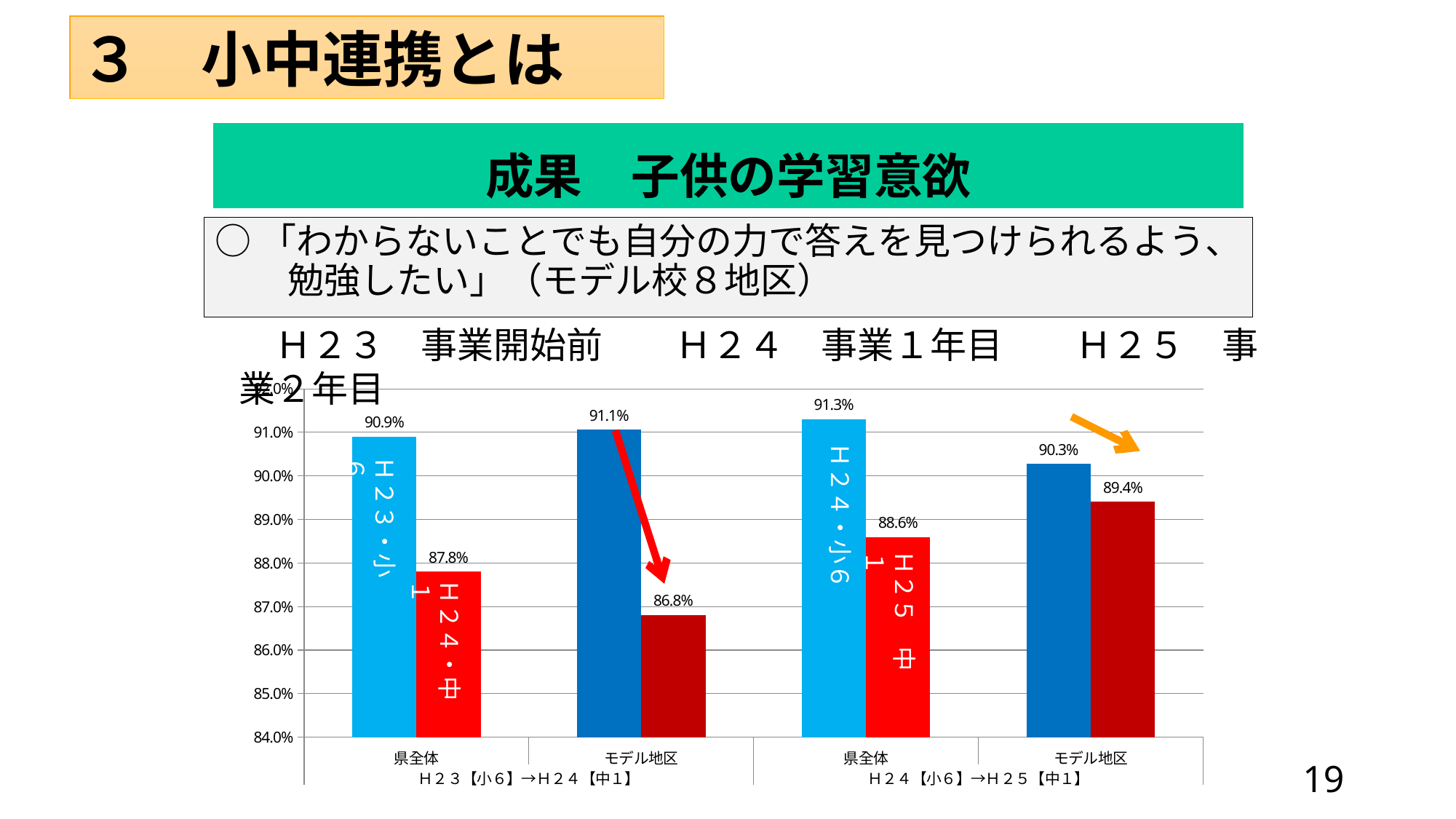
What is the difference between the 小6 and 中1 values for モデル地区 in the H24【小6】→H25【中1】 group? 0.9% In the H24【小6】→H25【中1】 group, what is the value of the H24・小6 bar for 県全体? 91.3% Is the value for 県全体 H24・中1 (87.8%) greater or less than 88.0%? less Which is larger: the 中1 value for 県全体 in the H23→H24 group (87.8%) or the 中1 value for 県全体 in the H24→H25 group (88.6%)? 88.6% (H24→H25 group) In the H23【小6】→H24【中1】 group, what is the value of the H23・小6 bar for 県全体? 90.9% What is the difference between the 小6 and 中1 values for モデル地区 in the H23【小6】→H24【中1】 group? 4.3% Which bar has the lowest value in the chart? モデル地区 H24・中1 (86.8%) Which bar has the highest value in the chart? 県全体 H24・小6 (91.3%) In the H24【小6】→H25【中1】 group, what is the value of the H25・中1 bar for モデル地区? 89.4% In the H23【小6】→H24【中1】 group, what is the value of the H24・中1 bar for モデル地区? 86.8% What kind of chart is shown on the slide? bar chart How many category groups are shown along the x axis of the chart? 4